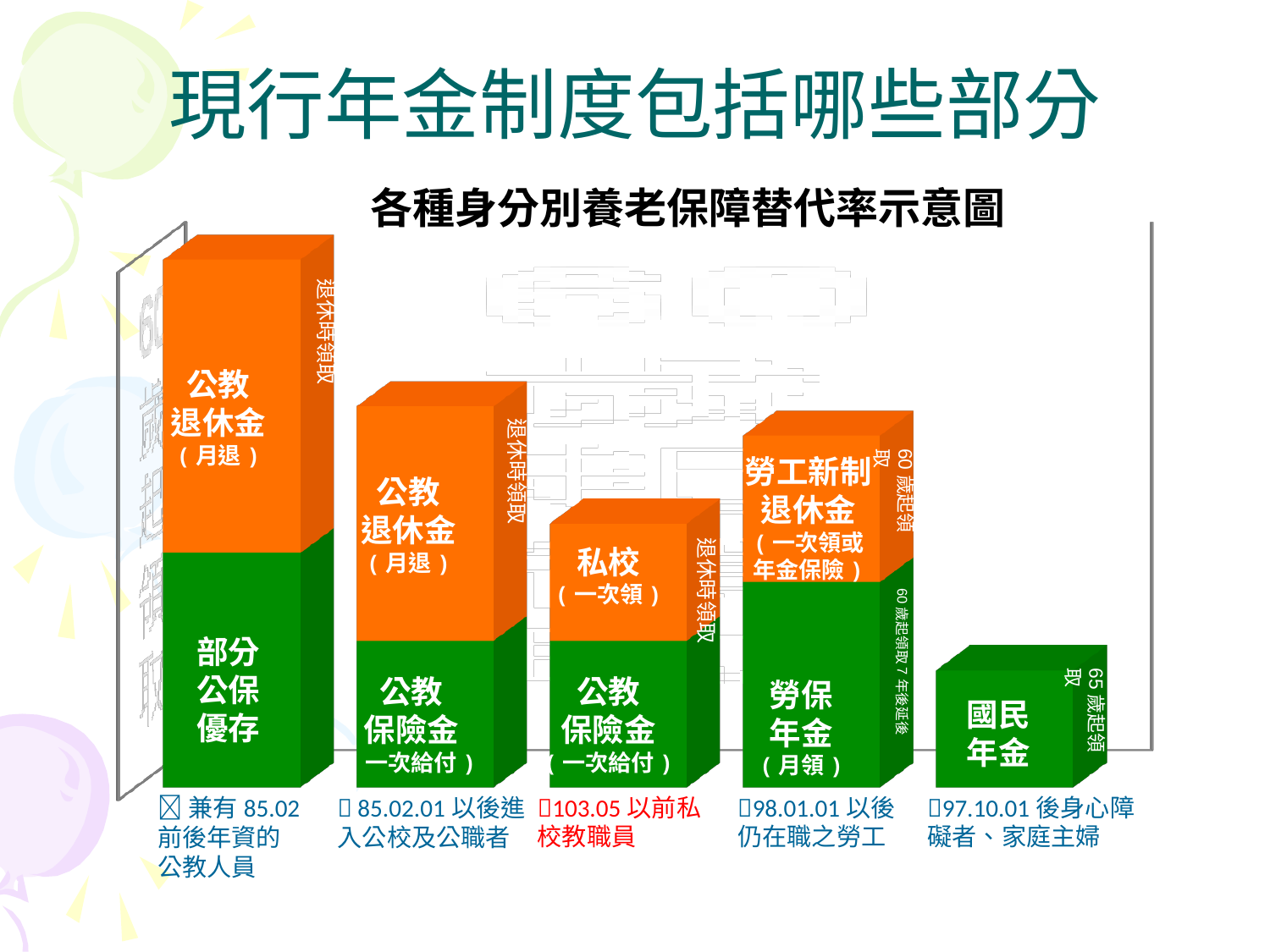
How many segments does the 國民年金 bar have? 1 Which bar is the tallest in the chart? The leftmost bar (公教退休金(月退) + 部分公保優存) What is the title of the chart? 各種身分別養老保障替代率示意圖 How many bars are plotted in the chart? 5 Which bar is the shortest in the chart? 國民年金 What kind of chart is shown on the slide? Stacked bar chart Do the bar heights generally rise or fall from left to right across the chart? Fall Which bar is taller: the 勞工新制退休金/勞保年金 bar or the 國民年金 bar? 勞工新制退休金/勞保年金 Which bar is taller: the 公教退休金(月退)/公教保險金(一次給付) bar (second from left) or the 私校(一次領)/公教保險金(一次給付) bar (third from left)? The second from left (公教退休金(月退)/公教保險金(一次給付)) What colour is the 國民年金 bar? Green